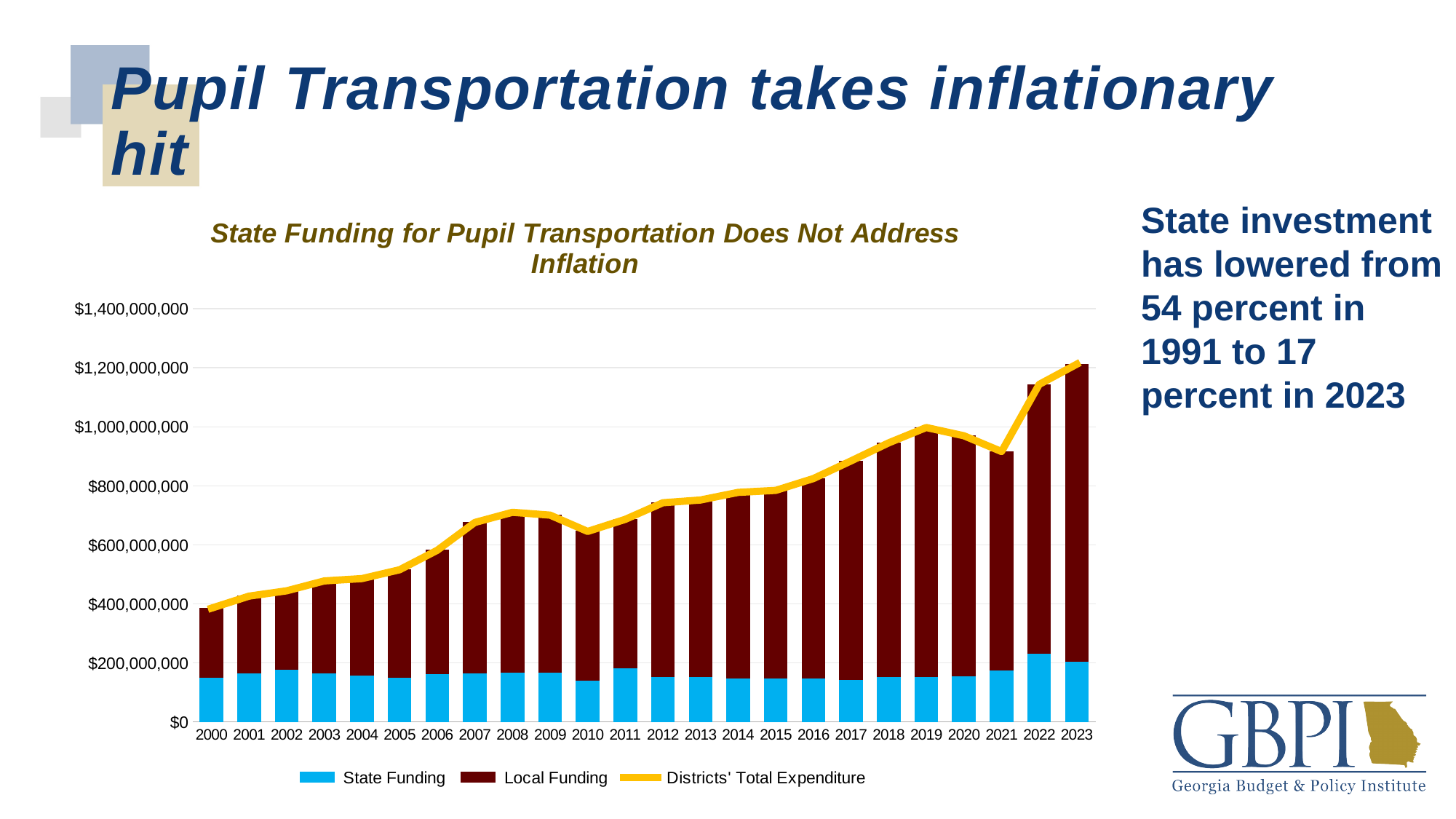
Which year has the highest total bar in the chart? 2023 Is the total bar for 2022 greater or less than $1,000,000,000? greater Is the total bar for 2007 greater or less than $600,000,000? greater Is the total bar for 2010 greater or less than $800,000,000? less What kind of chart is shown on the slide? Stacked bar chart with a line Which year has the lowest total bar in the chart? 2000 How many years are shown along the x axis of the chart? 24 Does the Districts' Total Expenditure line generally rise or fall from 2000 to 2023? rise What is the title of the chart? State Funding for Pupil Transportation Does Not Address Inflation Which year has the larger total bar, 2021 or 2022? 2022 How many series does the chart legend list? 3